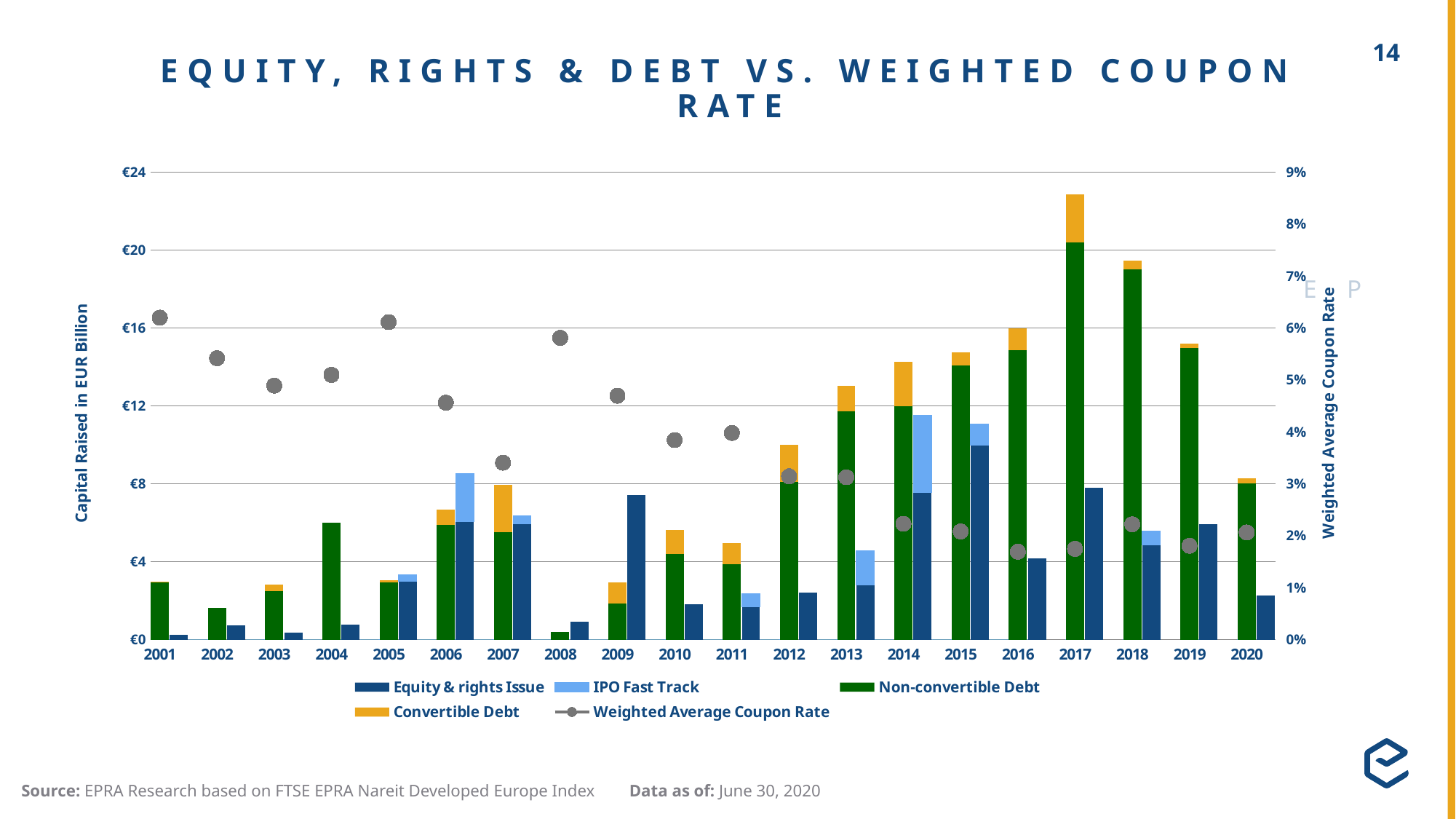
Is the total debt bar for 2017 greater or less than €20 billion? greater Does the Weighted Average Coupon Rate generally rise or fall from 2001 to 2020? fall In which year is the debt bar (Non-convertible plus Convertible Debt) the tallest? 2017 How many series does the chart legend list? 5 What kind of chart is this? Stacked bar chart combined with a marker/line series Is the Weighted Average Coupon Rate for 2001 greater or less than 5%? greater Is the Equity & rights Issue bar for 2015 greater or less than €8 billion? greater How many years are shown on the x axis of the chart? 20 What is the title of the left vertical axis? Capital Raised in EUR Billion What colour represents Non-convertible Debt in the chart? Green Which is taller in 2009: the Equity & rights Issue bar or the debt bar? Equity & rights Issue bar